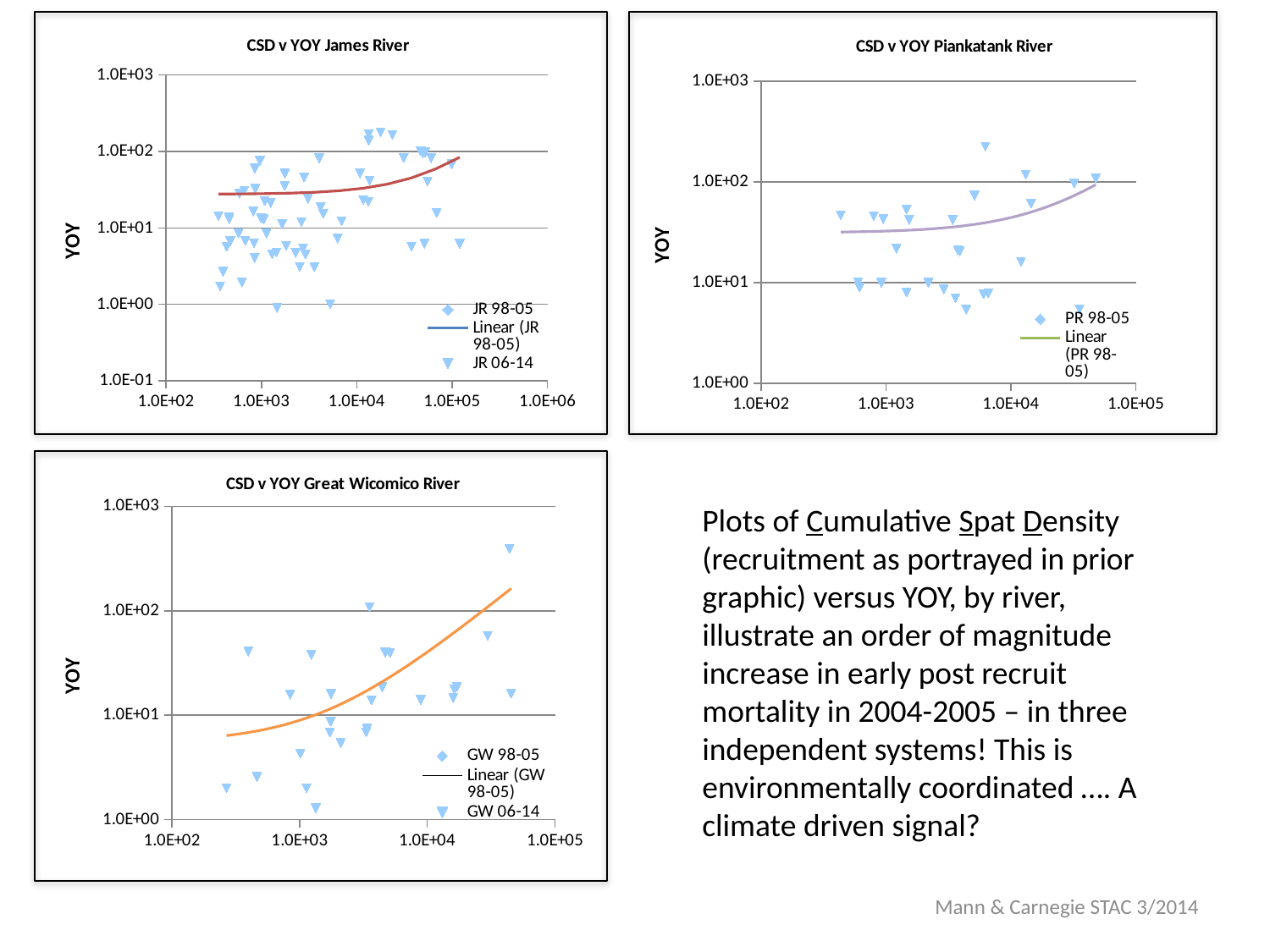
In the 'CSD v YOY Great Wicomico River' chart, does the fitted trend line rise or fall from left to right? Rises How many entries does the legend of the 'CSD v YOY Piankatank River' chart list? 2 What is the highest tick value shown on the horizontal axis of the 'CSD v YOY James River' chart? 1.0E+06 How many entries does the legend of the 'CSD v YOY James River' chart list? 3 In the 'CSD v YOY Piankatank River' chart, is the highest plotted YOY value greater or less than 1.0E+02? greater What is the label on the vertical axis of the 'CSD v YOY James River' chart? YOY How many charts are shown on the slide? 3 What kind of chart is the 'CSD v YOY James River' chart? Scatter chart In the 'CSD v YOY Great Wicomico River' chart, is the highest plotted YOY value greater or less than 1.0E+02? greater How many entries does the legend of the 'CSD v YOY Great Wicomico River' chart list? 3 In the 'CSD v YOY Piankatank River' chart, is the lowest plotted YOY value greater or less than 1.0E+01? less